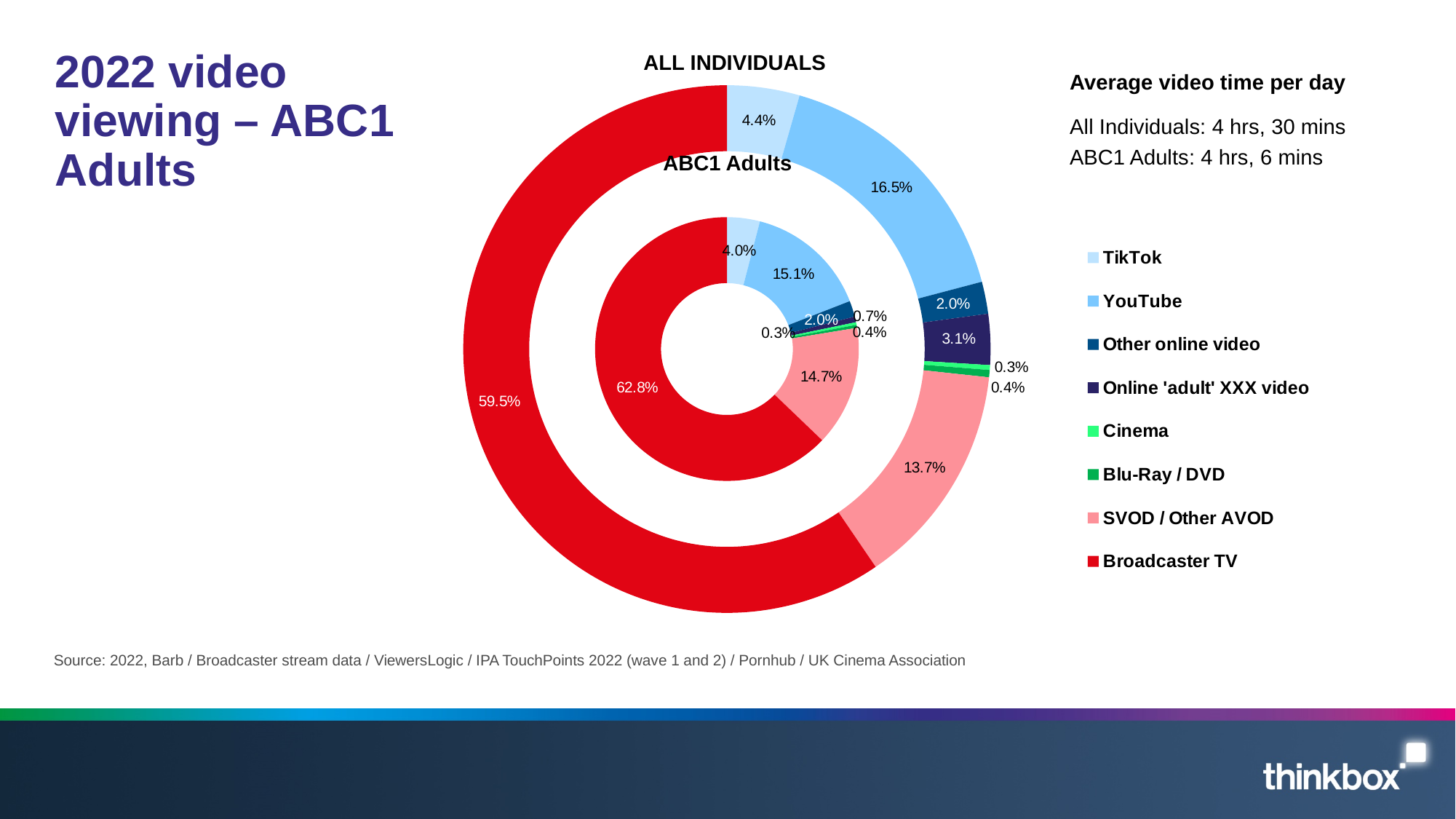
Which category has the largest share in the ALL INDIVIDUALS ring? Broadcaster TV In the ALL INDIVIDUALS ring, what share is YouTube? 16.5% In the ABC1 Adults ring, what share is YouTube? 15.1% In the ABC1 Adults ring, what share is TikTok? 4.0% What type of chart is shown on the slide? Doughnut chart According to the slide, what is the average video time per day for ABC1 Adults? 4 hrs, 6 mins In the ABC1 Adults ring, what share is Broadcaster TV? 62.8% In the ALL INDIVIDUALS ring, what share is Broadcaster TV? 59.5% How many categories does the legend list? 8 What is the difference between the Broadcaster TV share for ABC1 Adults and for ALL INDIVIDUALS? 3.3 percentage points In the ALL INDIVIDUALS ring, what share is SVOD / Other AVOD? 13.7% Is the YouTube share larger for ALL INDIVIDUALS or for ABC1 Adults? ALL INDIVIDUALS